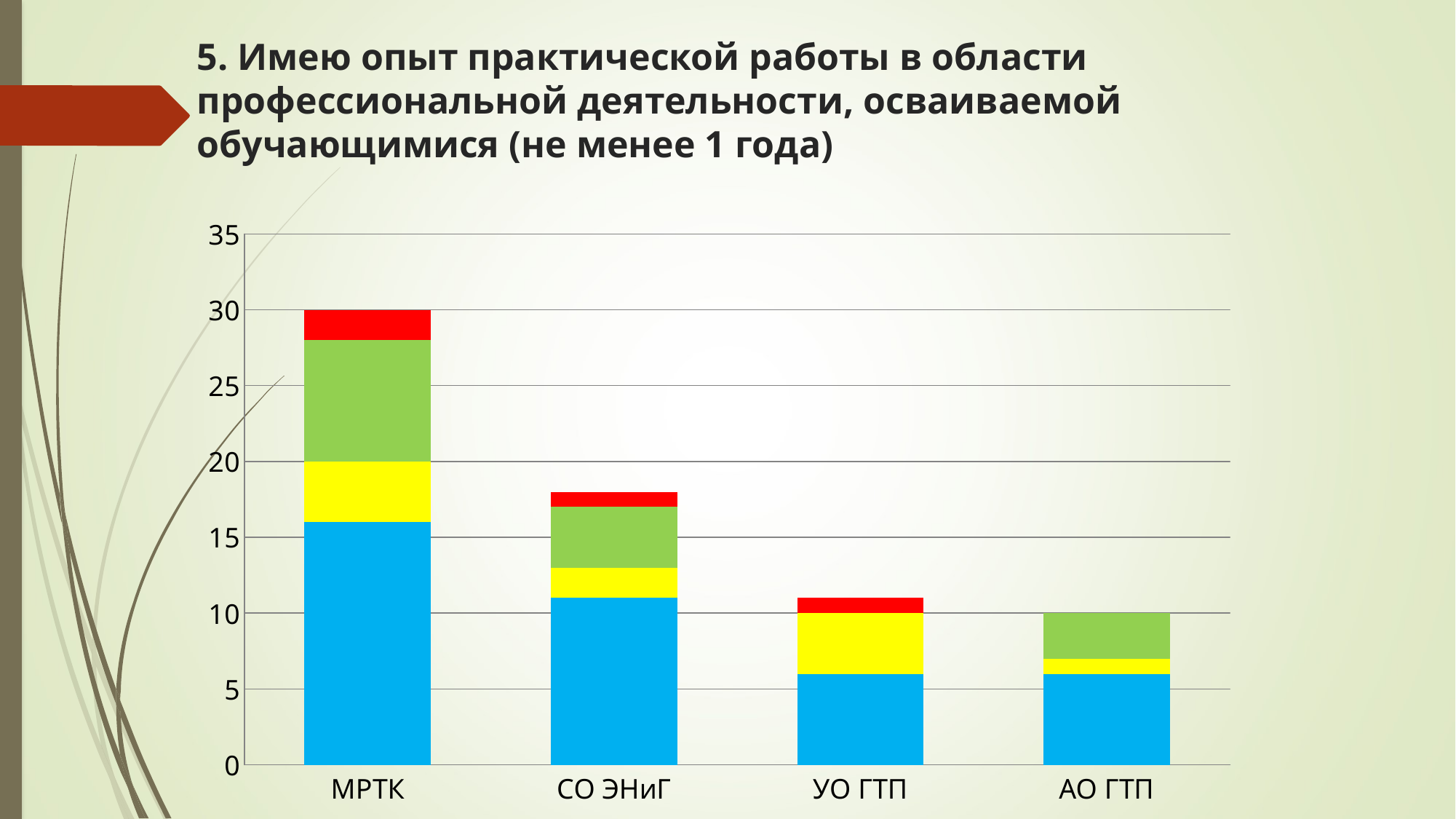
Is the total value for УО ГТП greater or less than 10? greater Do the total bar heights rise or fall from left to right along the x axis? fall What is the difference between the total for МРТК and the total for АО ГТП? 20 Which stacked bar is taller, МРТК or СО ЭНиГ? МРТК What is the total height of the stacked bar for АО ГТП? 10 How many coloured segments make up the bar for АО ГТП? 3 What is the total height of the stacked bar for МРТК? 30 Which category has the tallest stacked bar? МРТК Is the total value for СО ЭНиГ greater or less than 20? less What kind of chart is shown on the slide? Stacked bar chart How many categories are shown on the x axis of the chart? 4 Which category has the shortest stacked bar? АО ГТП